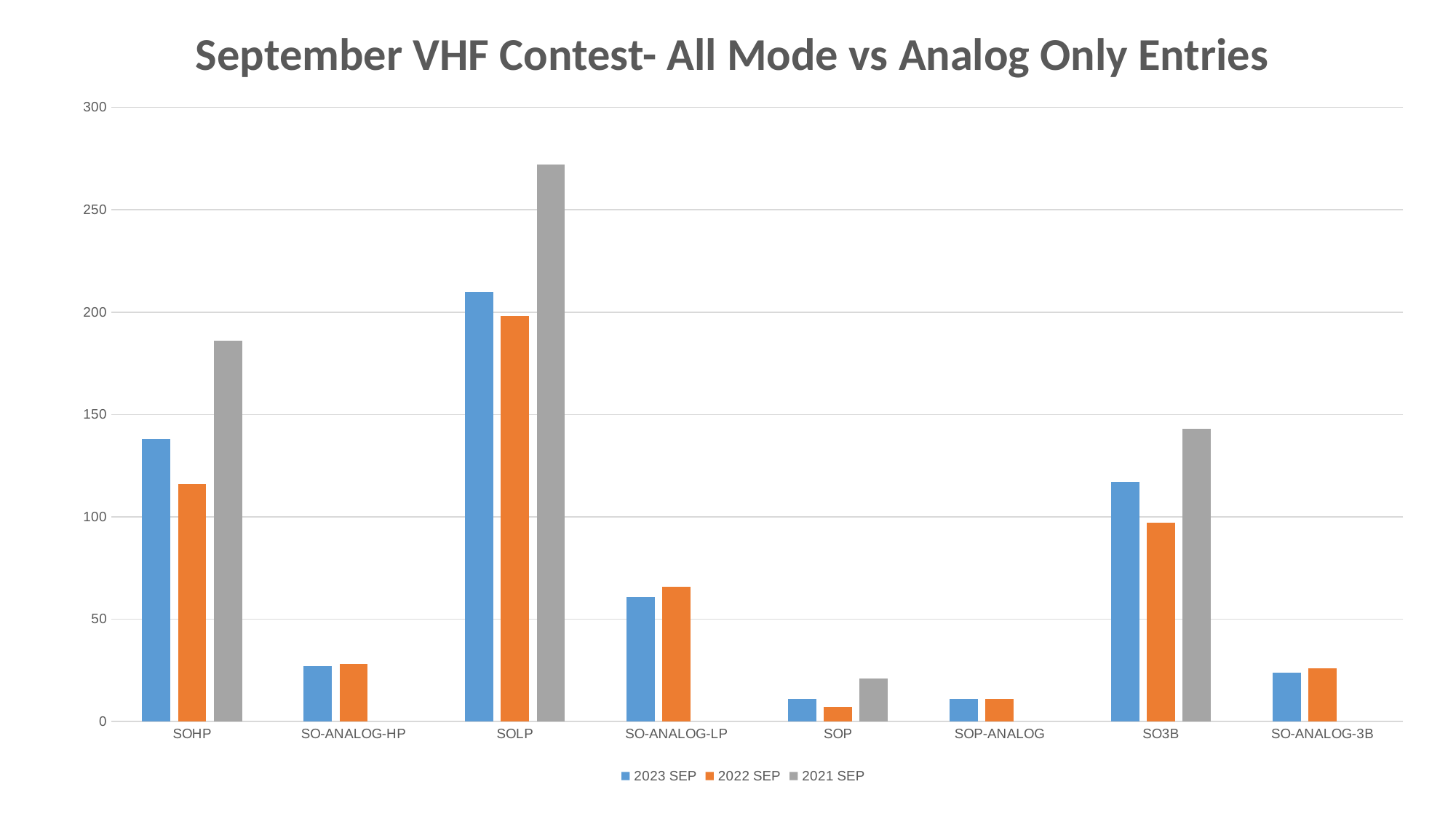
What kind of chart is shown on the slide? Bar chart Which category has the tallest bar in the chart? SOLP What is the title of the chart? September VHF Contest- All Mode vs Analog Only Entries Is the 2021 SEP value for SOLP greater or less than 250? greater How many series does the legend list? 3 Which series has the lowest value for SOP? 2022 SEP For SO3B, which is larger: the 2021 SEP value or the 2023 SEP value? 2021 SEP Is the 2023 SEP value for SOHP greater or less than 100? greater Is the 2021 SEP value for SO3B greater or less than 150? less For SOHP, which is larger: the 2023 SEP value or the 2022 SEP value? 2023 SEP How many categories are shown along the x axis? 8 Which series has the highest value for SOLP? 2021 SEP